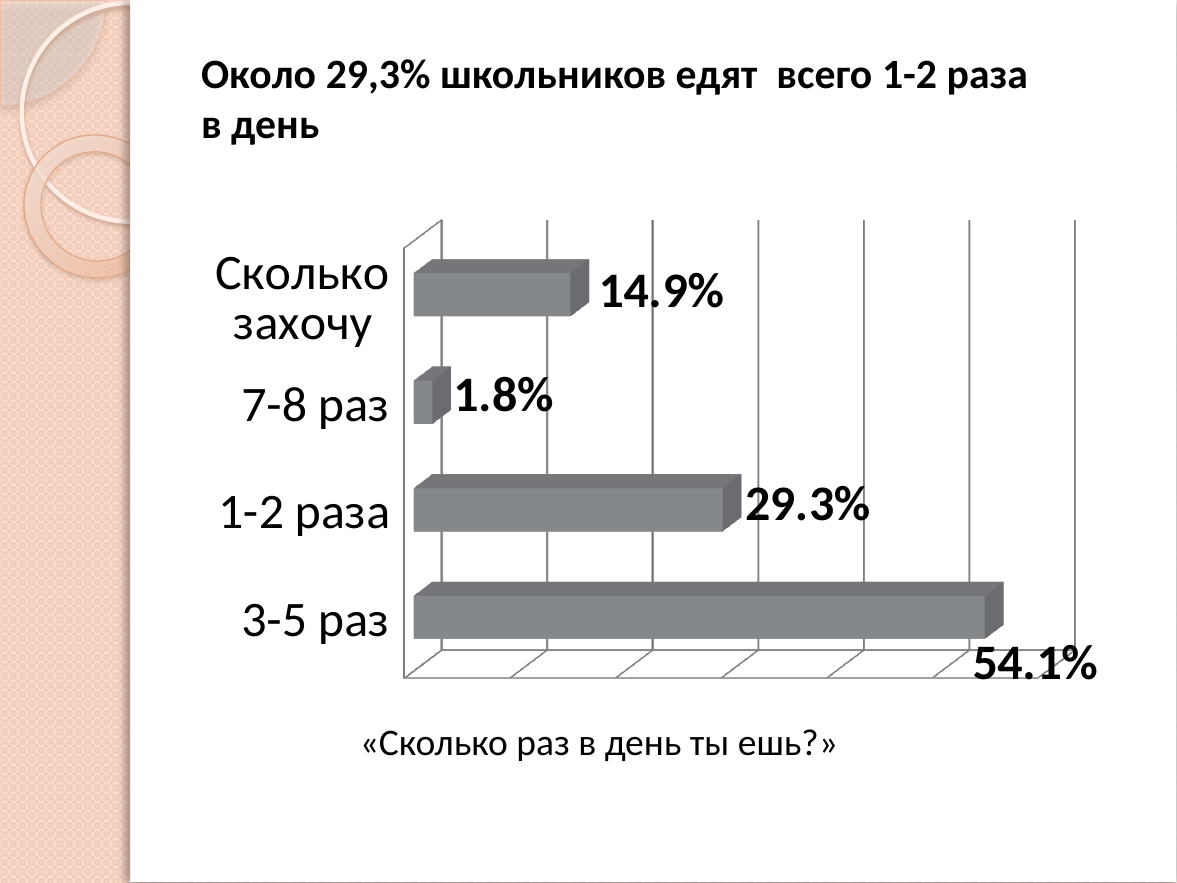
What kind of chart is shown on the slide? Bar chart Which category has the lowest value? 7-8 раз What is the value shown for "Сколько захочу"? 14.9% What is the value shown for "1-2 раза"? 29.3% What percentage of schoolchildren answered "3-5 раз"? 54.1% Which is larger, the value for "1-2 раза" or the value for "Сколько захочу"? 1-2 раза What question is the chart based on, as written below it? «Сколько раз в день ты ешь?» What is the difference between the values for "Сколько захочу" and "7-8 раз"? 13.1% What is the difference between the values for "3-5 раз" and "1-2 раза"? 24.8% Which category has the highest value? 3-5 раз What is the value shown for "7-8 раз"? 1.8% How many categories are shown in the chart? 4